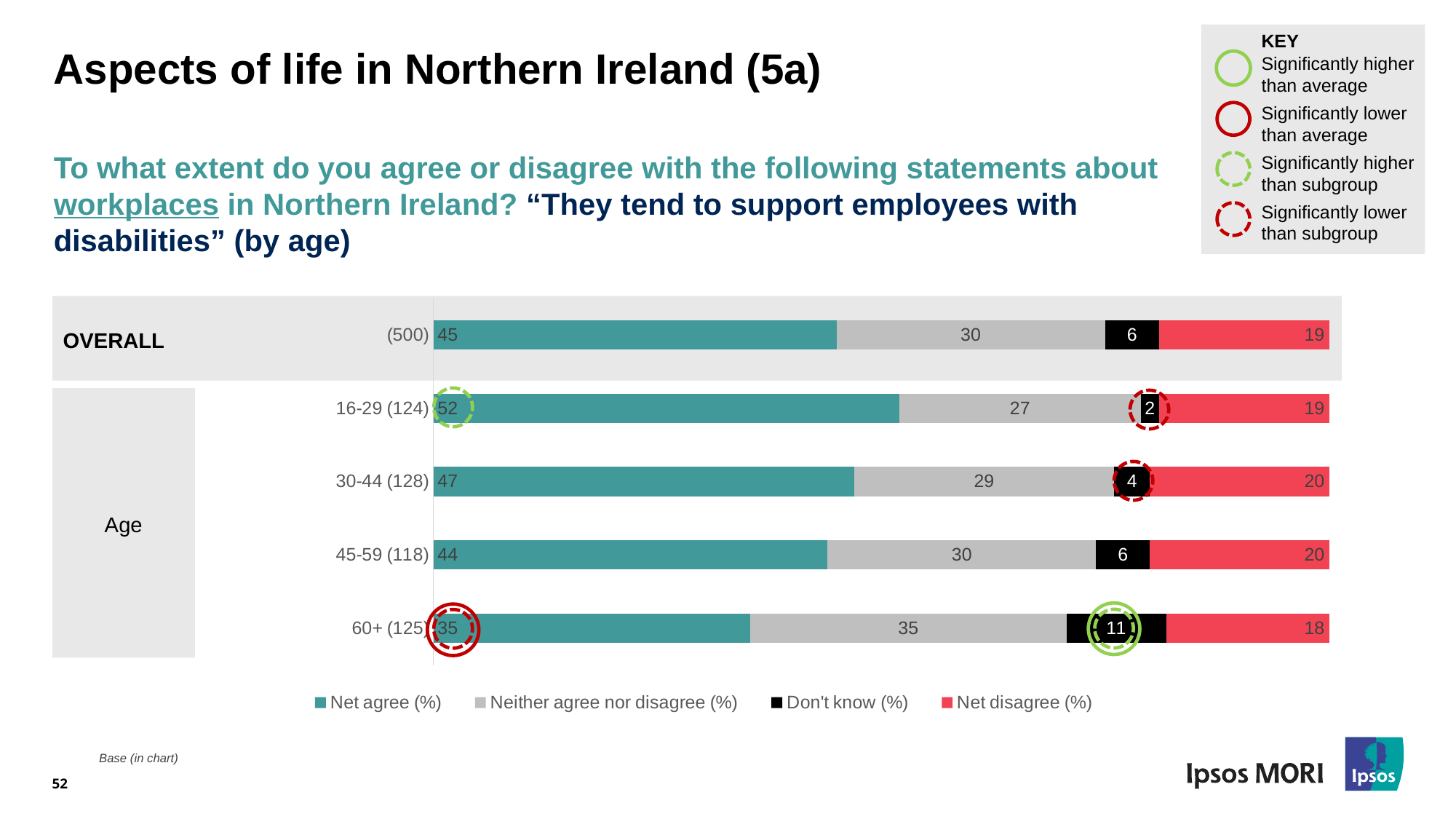
What is the Net agree (%) value for the OVERALL bar? 45 Which age group has the lowest Don't know (%) value? 16-29 Which age group has the highest Net agree (%) value? 16-29 How many age groups are shown in the chart, excluding OVERALL? 4 Which is larger: the Neither agree nor disagree (%) value for 60+ or for 16-29? 60+ What is the Neither agree nor disagree (%) value for the 45-59 age group? 30 What kind of chart is shown on the slide? Stacked bar chart What is the Net disagree (%) value for the 30-44 age group? 20 What is the Don't know (%) value for the 60+ age group? 11 How many series does the legend list? 4 What is the base size shown for the 30-44 age group? 128 What is the difference between the Net agree (%) values for the 16-29 and 60+ age groups? 17